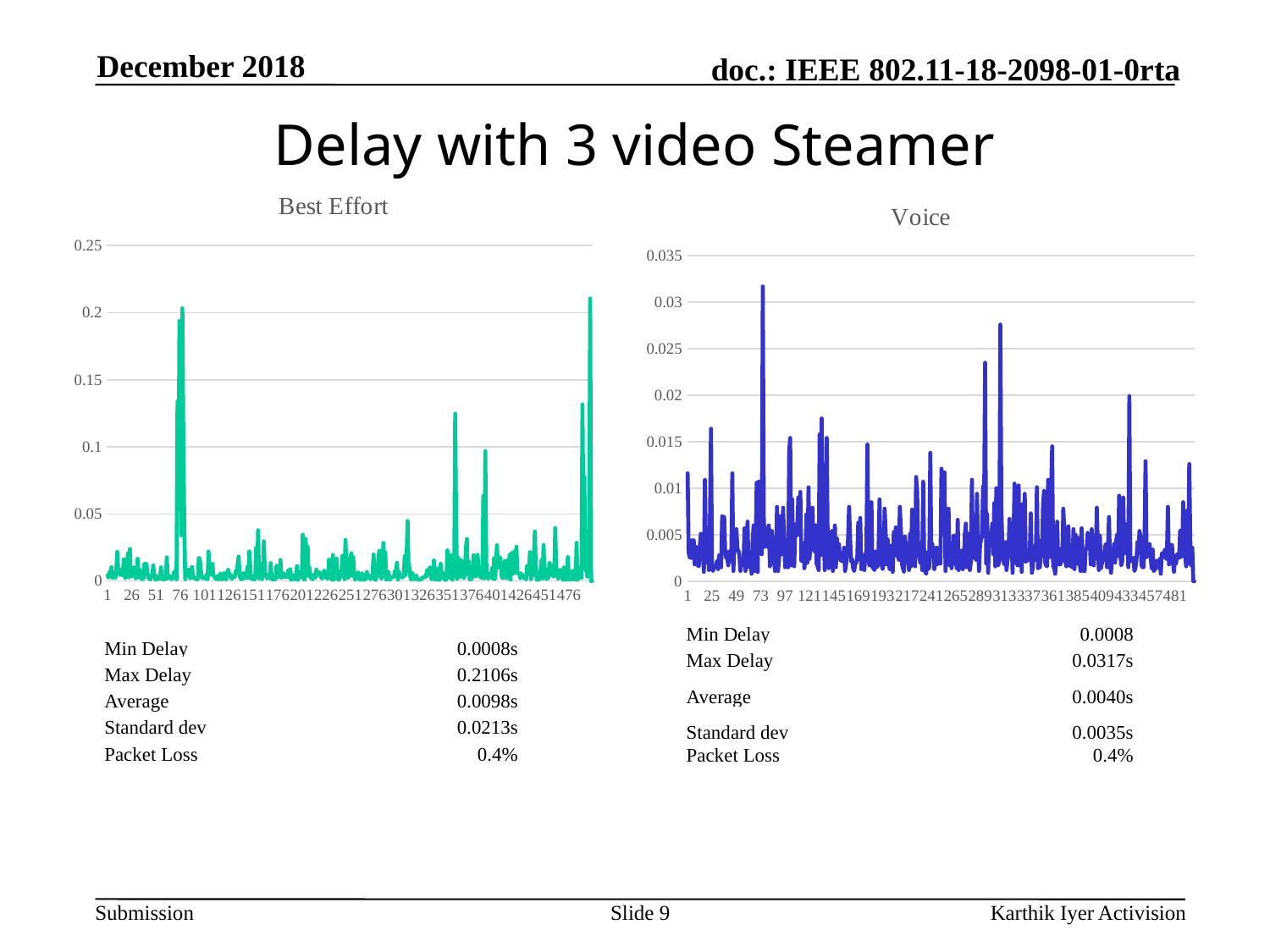
What is the title of the chart on the right side of the slide? Voice In the Voice chart, is the tallest spike near x = 73 greater or less than 0.03? greater What is the highest tick value shown on the y axis of the Voice chart? 0.035 In the Voice chart, is the spike near x = 433 greater or less than 0.025? less In the Best Effort chart, is the spike at the far right end of the series greater or less than 0.2? greater What kind of chart is the Voice chart? line chart Which chart has the higher maximum value on its y axis, Best Effort or Voice? Best Effort What is the title of the chart on the left side of the slide? Best Effort What kind of chart is the Best Effort chart? line chart